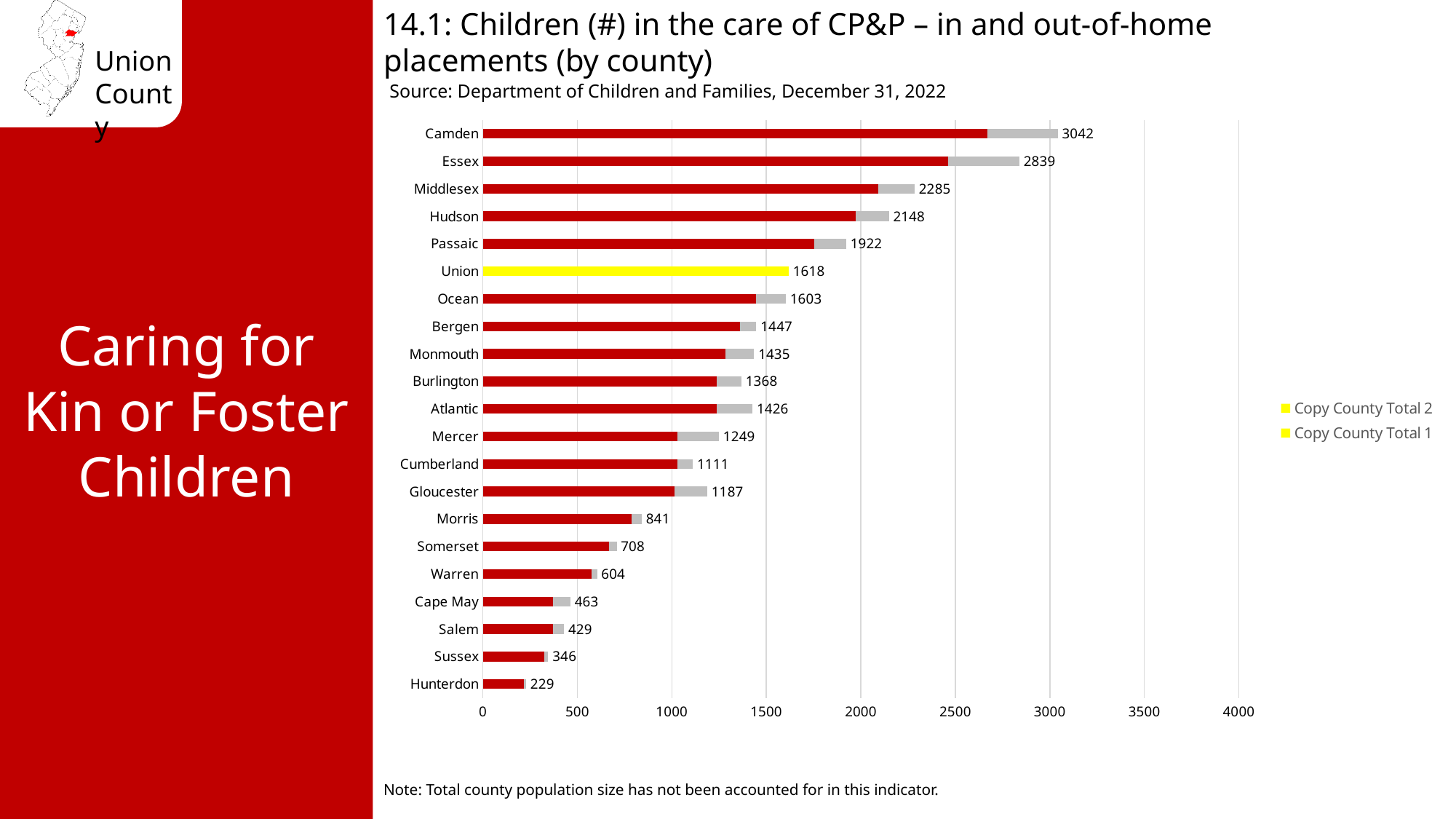
What is the total number of children in the care of CP&P for Hunterdon? 229 How many series does the legend list? 2 Which county has the highest total number of children in the care of CP&P? Camden Which county has the lowest total number of children in the care of CP&P? Hunterdon Is the total for Passaic greater or less than 2000? less What is the total number of children in the care of CP&P for Camden? 3042 How many counties are shown in the chart? 21 Which county's bar is highlighted in yellow? Union What kind of chart is shown on the slide? Bar chart Which county has a larger total, Atlantic or Burlington? Atlantic What is the total number of children in the care of CP&P for Union? 1618 What is the difference between the totals for Camden and Essex? 203